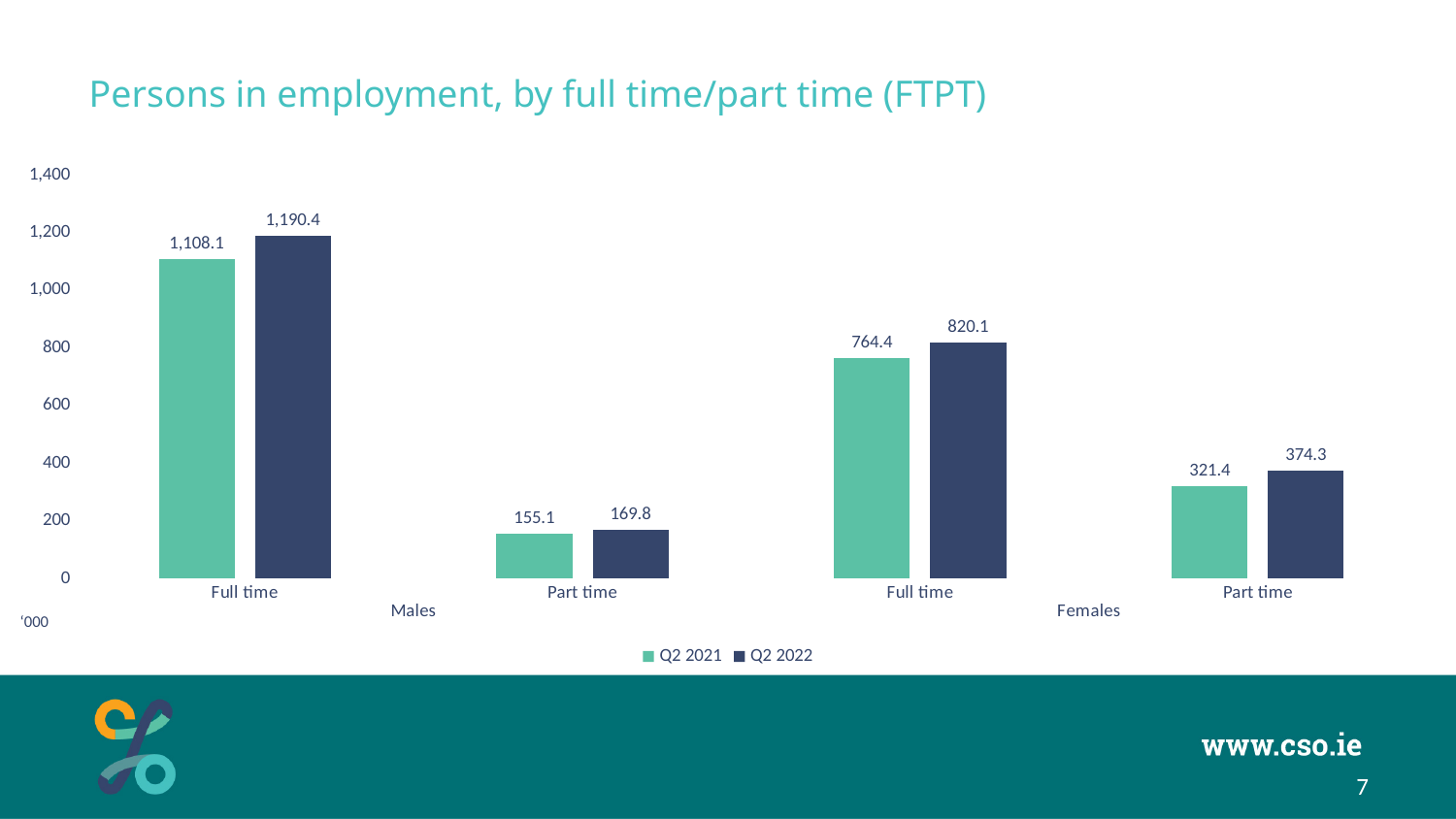
What is the difference between the Q2 2022 and Q2 2021 values for Males Full time? 82.3 What is the difference between the Q2 2022 and Q2 2021 values for Females Full time? 55.7 What is the title of the chart? Persons in employment, by full time/part time (FTPT) Is the value for Females Full time in Q2 2021 greater or less than 800? less How many series does the legend list? 2 Which category has the lowest value in Q2 2022? Males Part time Which is larger: Females Part time in Q2 2022 or Males Part time in Q2 2022? Females Part time in Q2 2022 What kind of chart is shown on the slide? Bar chart What is the value for Females Part time in Q2 2021? 321.4 What is the value for Males Full time in Q2 2022? 1,190.4 What is the value for Males Part time in Q2 2022? 169.8 Which category has the highest value in Q2 2021? Males Full time